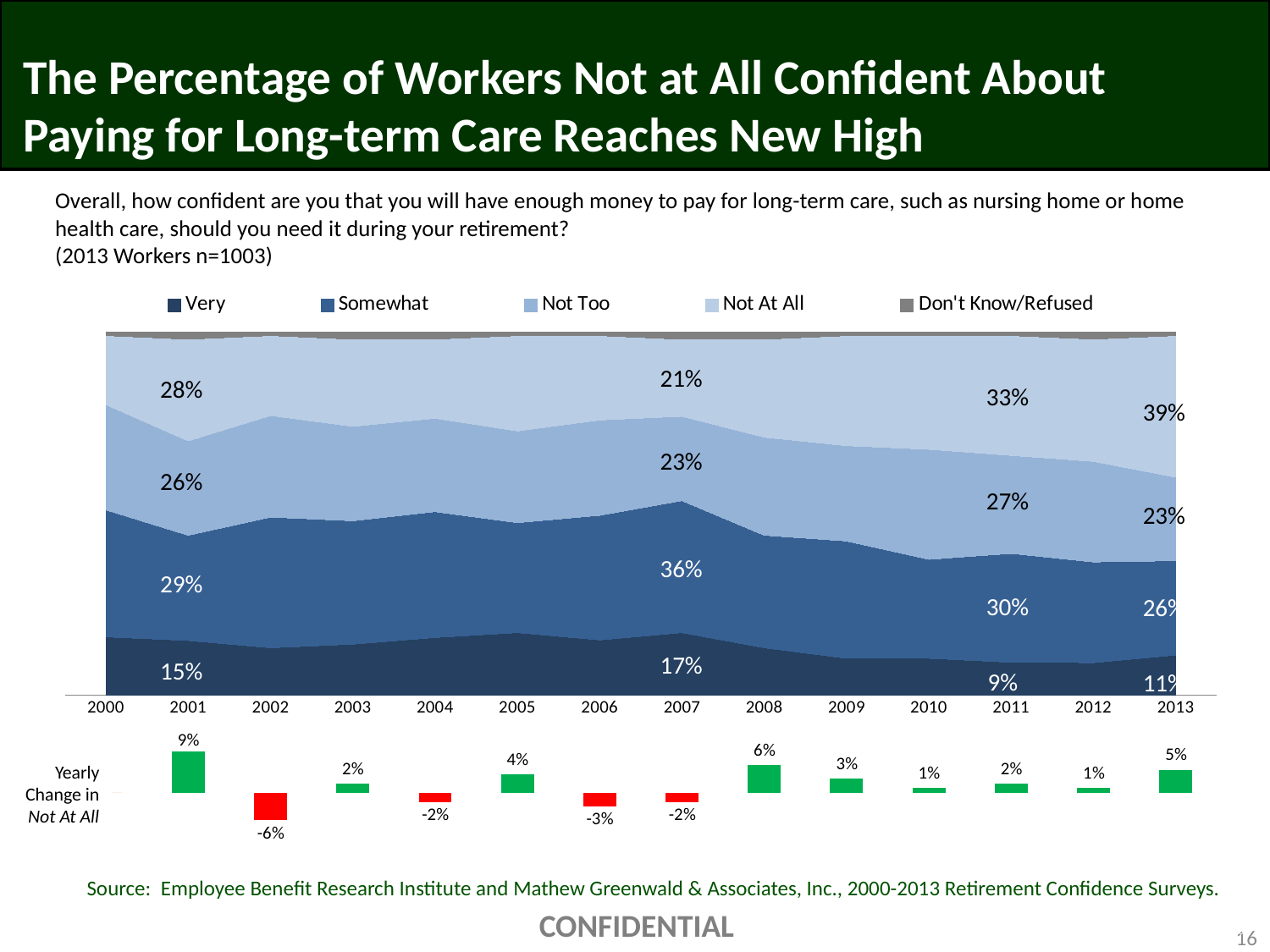
What kind of chart is the main chart showing confidence levels from 2000 to 2013? Stacked area chart In the main chart, by how many percentage points did the Not At All value change from 2011 (33%) to 2013 (39%)? 6 percentage points How many series does the legend of the main chart list? 5 In the main chart, what is the Not At All value for 2013? 39% In the main chart, what is the Not Too value for 2001? 26% In the Yearly Change in Not At All bar chart, which year has the lowest value? 2002 How many bars are shown in the Yearly Change in Not At All bar chart? 13 In the main chart, what is the Somewhat value for 2007? 36% In the Yearly Change in Not At All bar chart, what is the value for 2008? 6% In the main chart, which is larger for 2013: Not At All or Not Too? Not At All In the main chart, what is the Very value for 2011? 9% In the Yearly Change in Not At All bar chart, which year has the highest value? 2001